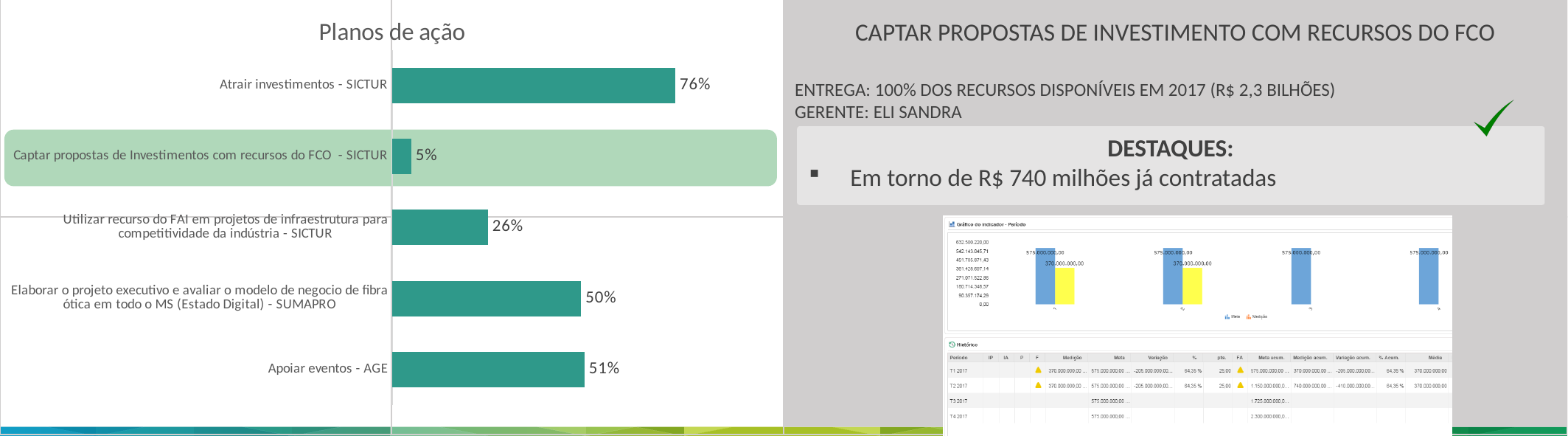
In the 'Planos de ação' chart, which category has the lowest value? Captar propostas de Investimentos com recursos do FCO - SICTUR In the 'Planos de ação' chart, what is the value for 'Elaborar o projeto executivo e avaliar o modelo de negocio de fibra ótica em todo o MS (Estado Digital) - SUMAPRO'? 50% In the 'Planos de ação' chart, which is larger: 'Atrair investimentos - SICTUR' or 'Utilizar recurso do FAI em projetos de infraestrutura para competitividade da indústria - SICTUR'? Atrair investimentos - SICTUR In the 'Planos de ação' chart, what is the difference between 'Atrair investimentos - SICTUR' and 'Apoiar eventos - AGE'? 25% What kind of chart is the 'Planos de ação' chart on the left of the slide? Bar chart In the 'Planos de ação' chart, which category has the highest value? Atrair investimentos - SICTUR In the 'Planos de ação' chart, what is the value for 'Utilizar recurso do FAI em projetos de infraestrutura para competitividade da indústria - SICTUR'? 26% In the 'Planos de ação' chart, what is the value for 'Atrair investimentos - SICTUR'? 76% In the 'Planos de ação' chart, what is the value for 'Apoiar eventos - AGE'? 51% In the 'Planos de ação' chart, what is the value for 'Captar propostas de Investimentos com recursos do FCO - SICTUR'? 5% How many categories are shown in the 'Planos de ação' chart? 5 In the 'Planos de ação' chart, what is the difference between 'Utilizar recurso do FAI em projetos de infraestrutura para competitividade da indústria - SICTUR' and 'Captar propostas de Investimentos com recursos do FCO - SICTUR'? 21%